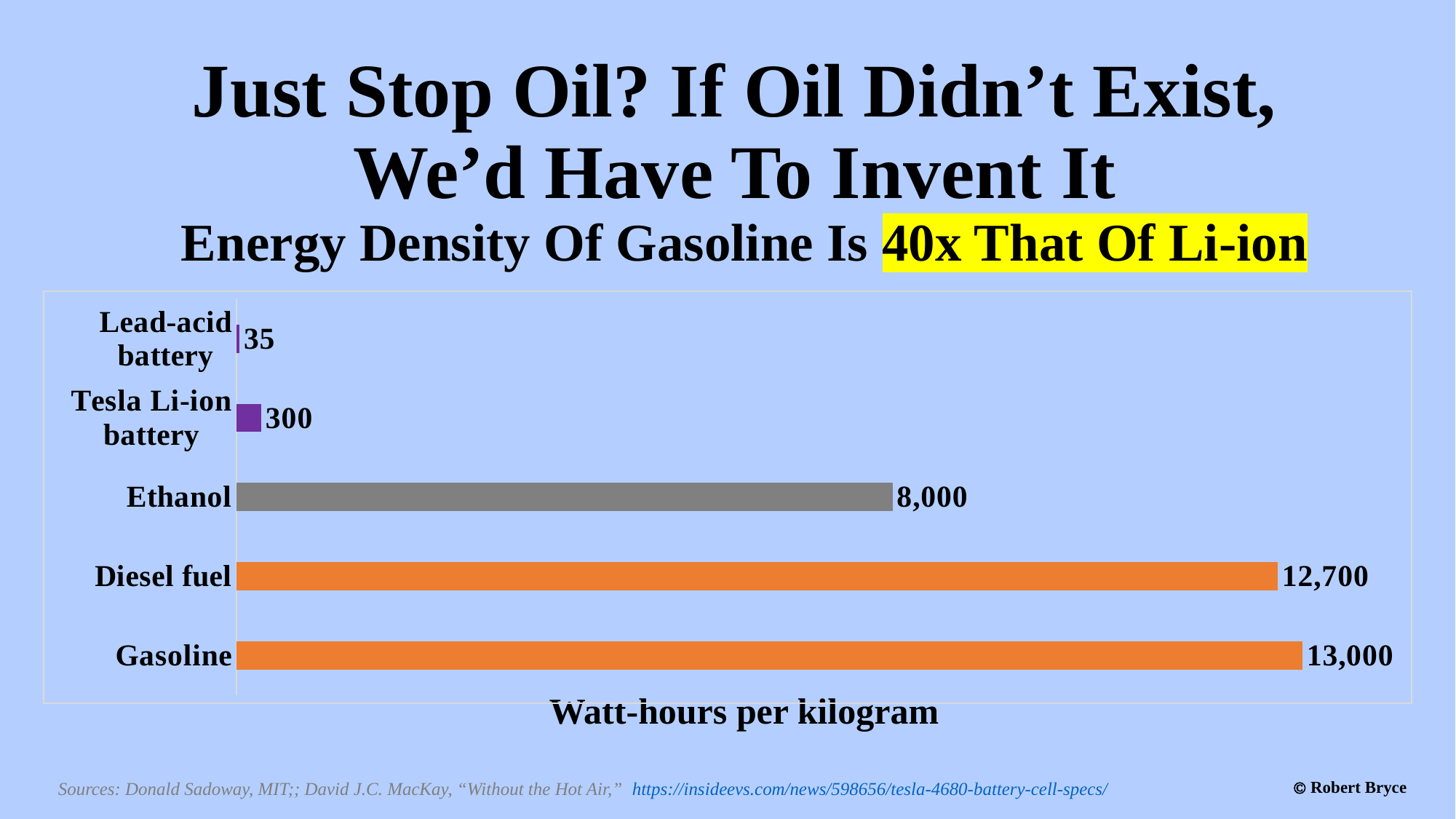
What is the value shown for Diesel fuel? 12,700 What is the value shown for the Lead-acid battery? 35 What is the difference between the values for Gasoline and Diesel fuel? 300 What is the difference between the values for Ethanol and the Tesla Li-ion battery? 7,700 What is the value shown for the Tesla Li-ion battery? 300 Which category has the lowest value in the chart? Lead-acid battery Which category has the highest value in the chart? Gasoline How many categories are plotted in the chart? 5 What is the energy density value shown for Gasoline? 13,000 What is the value shown for Ethanol? 8,000 Which has a larger value, Ethanol or Diesel fuel? Diesel fuel What type of chart is shown on the slide? Bar chart